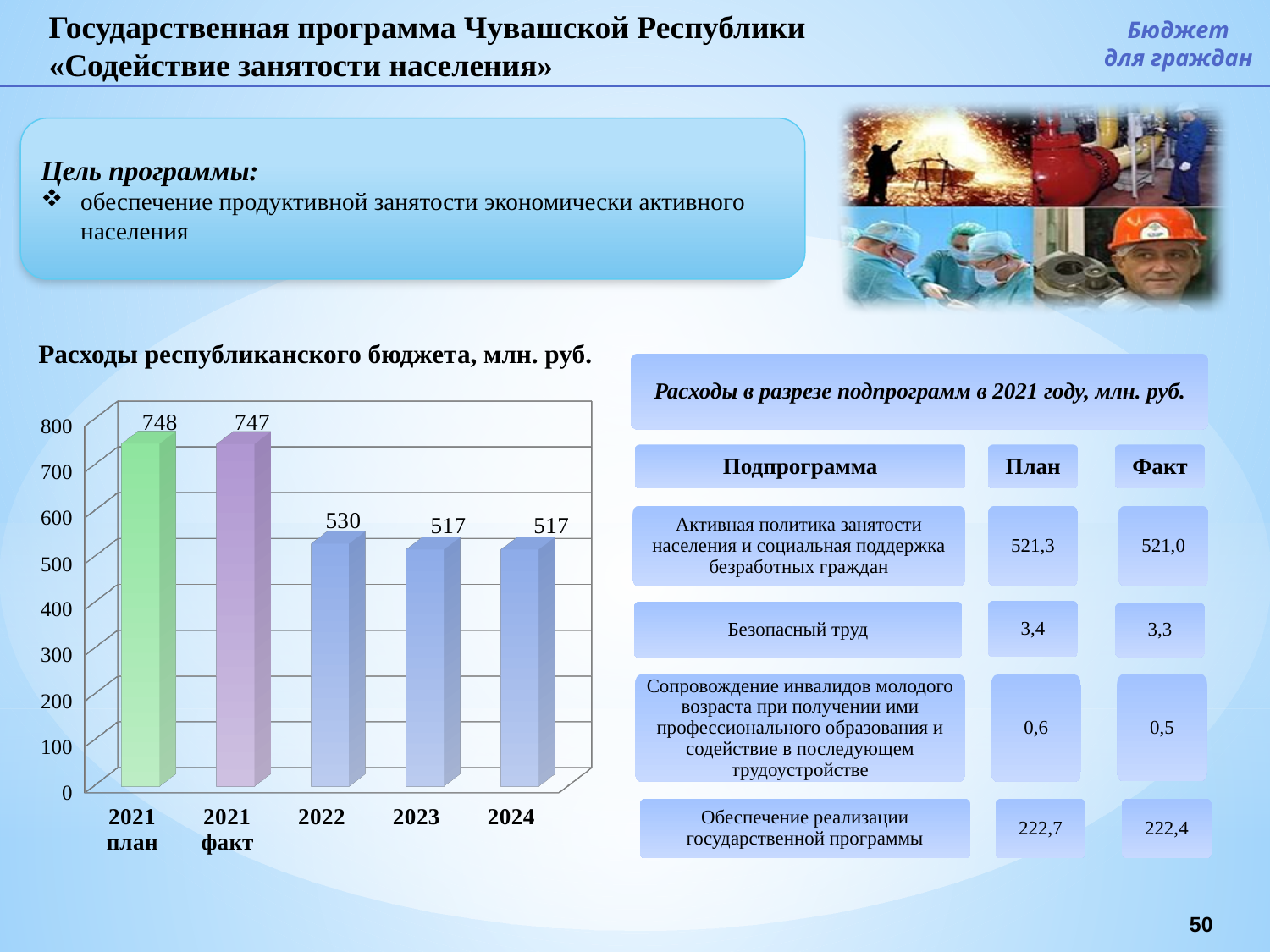
What is the title of the chart on the slide? Расходы республиканского бюджета, млн. руб. Which category has the highest value in the chart? 2021 план What kind of chart is shown on the slide? bar chart What is the value for 2024 in the chart? 517 What is the difference between the values for 2022 and 2023? 13 What is the value for 2021 факт in the chart? 747 How many bars are shown in the chart? 5 What is the difference between the values for 2021 план and 2021 факт? 1 Is the value for 2023 greater or less than 600? less Which is larger, the value for 2021 факт or the value for 2022? 2021 факт What is the value for 2022 in the chart? 530 What is the value for 2021 план in the chart "Расходы республиканского бюджета, млн. руб."? 748